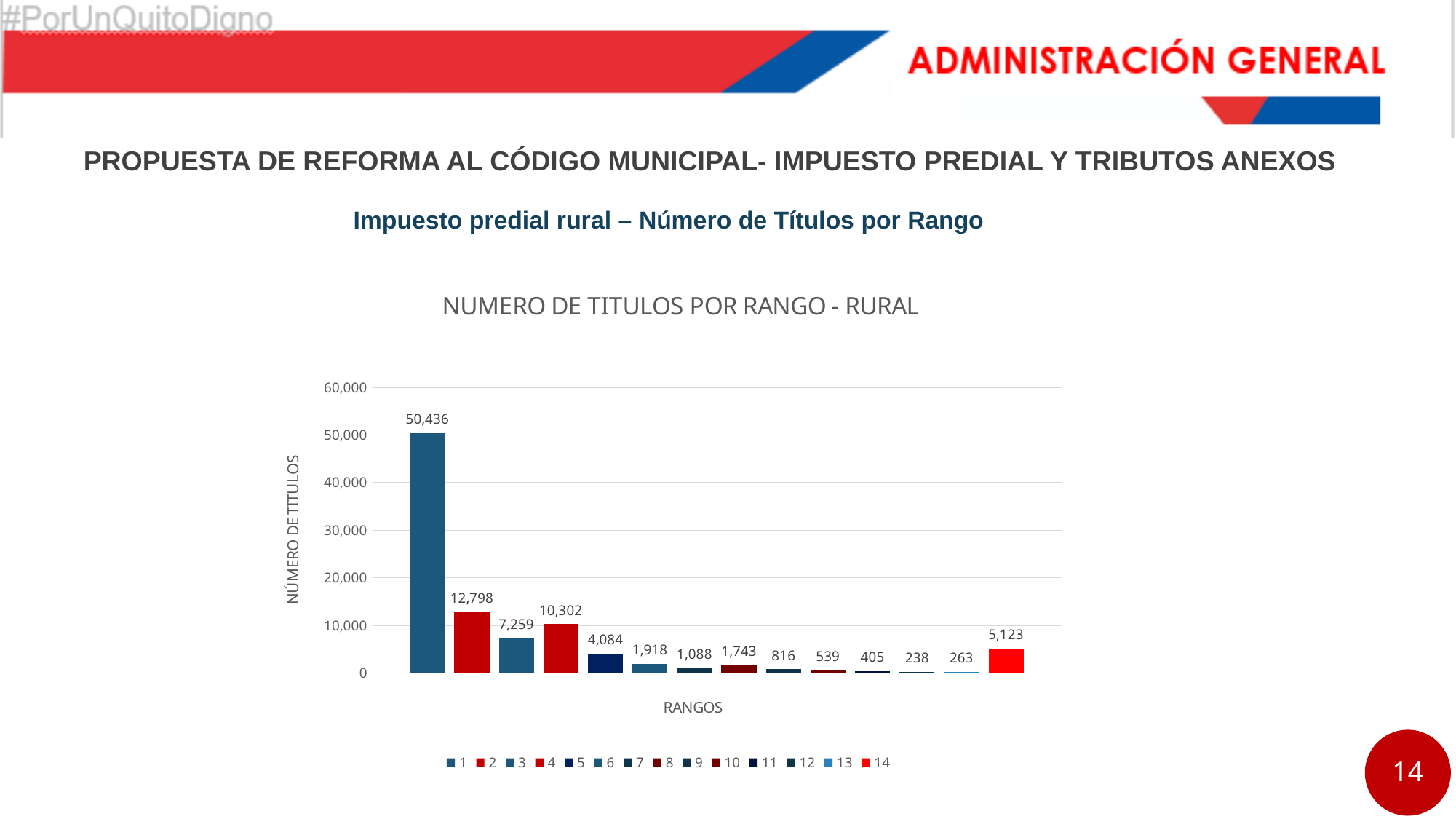
How many entries does the legend list? 14 Which has more titles, range 4 or range 5? Range 4 What is the number of titles for range 8? 1,743 What is the title of the chart? NUMERO DE TITULOS POR RANGO - RURAL What is the number of titles for range 1? 50,436 Which range has the lowest number of titles? 12 What is the difference between the number of titles for range 2 and range 3? 5,539 What type of chart is shown on the slide? Bar chart Which range has the highest number of titles? 1 What is the label of the y axis? NÚMERO DE TITULOS What is the number of titles for range 14? 5,123 How many ranges (bars) are plotted in the chart? 14